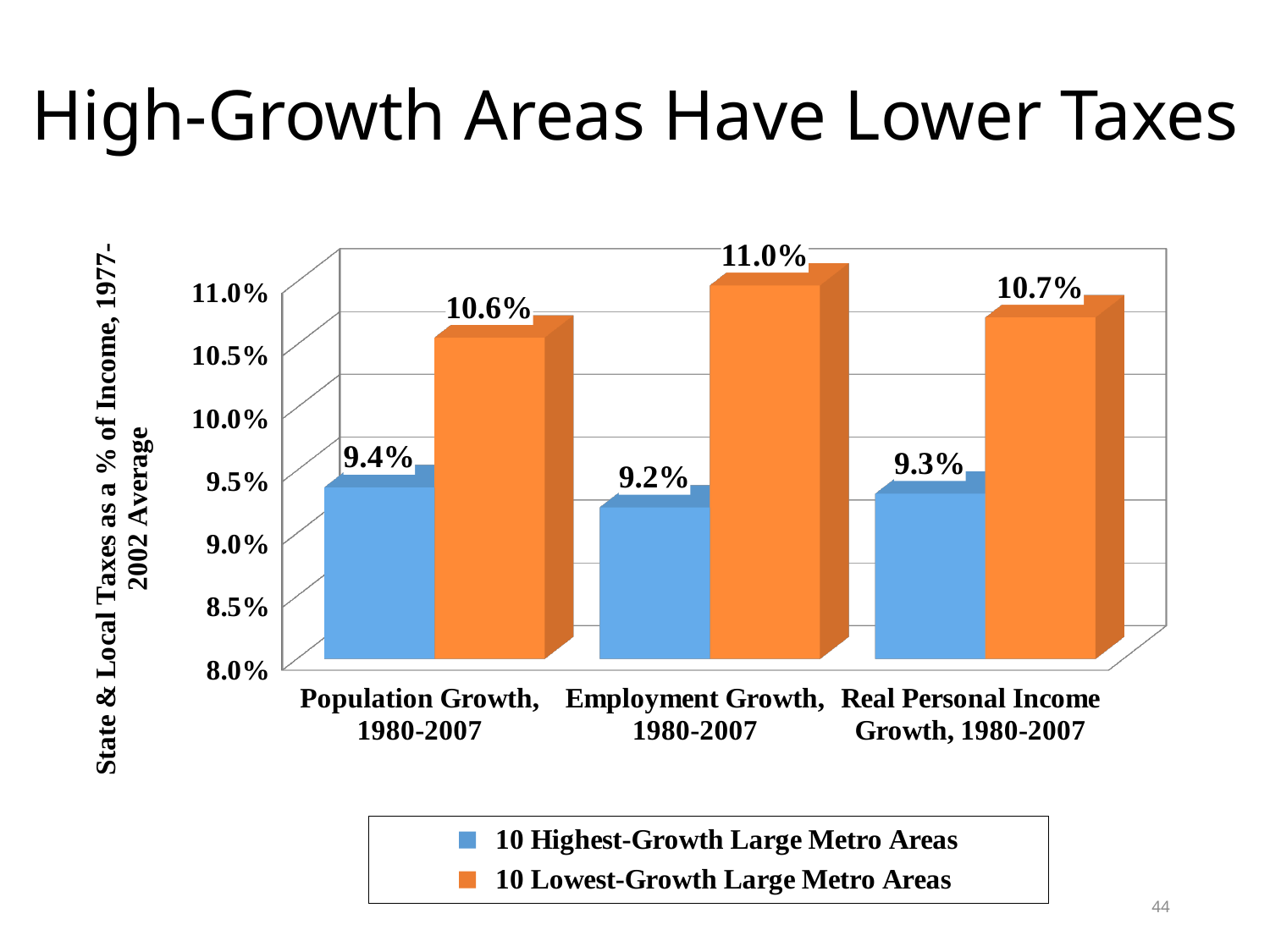
How many categories are shown on the x axis? 3 What is the value for the 10 Highest-Growth Large Metro Areas under Employment Growth, 1980-2007? 9.2% Which is larger under Real Personal Income Growth, 1980-2007: the 10 Highest-Growth or the 10 Lowest-Growth Large Metro Areas? 10 Lowest-Growth Large Metro Areas What is the value for the 10 Lowest-Growth Large Metro Areas under Real Personal Income Growth, 1980-2007? 10.7% What is the difference between the 10 Lowest-Growth and 10 Highest-Growth Large Metro Areas under Population Growth, 1980-2007? 1.2% What kind of chart is shown on the slide? Bar chart What is the title of the slide? High-Growth Areas Have Lower Taxes How many series does the legend list? 2 Which category has the lowest value for the 10 Highest-Growth Large Metro Areas? Employment Growth, 1980-2007 What is the value for the 10 Highest-Growth Large Metro Areas under Population Growth, 1980-2007? 9.4% What is the value for the 10 Lowest-Growth Large Metro Areas under Employment Growth, 1980-2007? 11.0% Which category has the highest value for the 10 Lowest-Growth Large Metro Areas? Employment Growth, 1980-2007